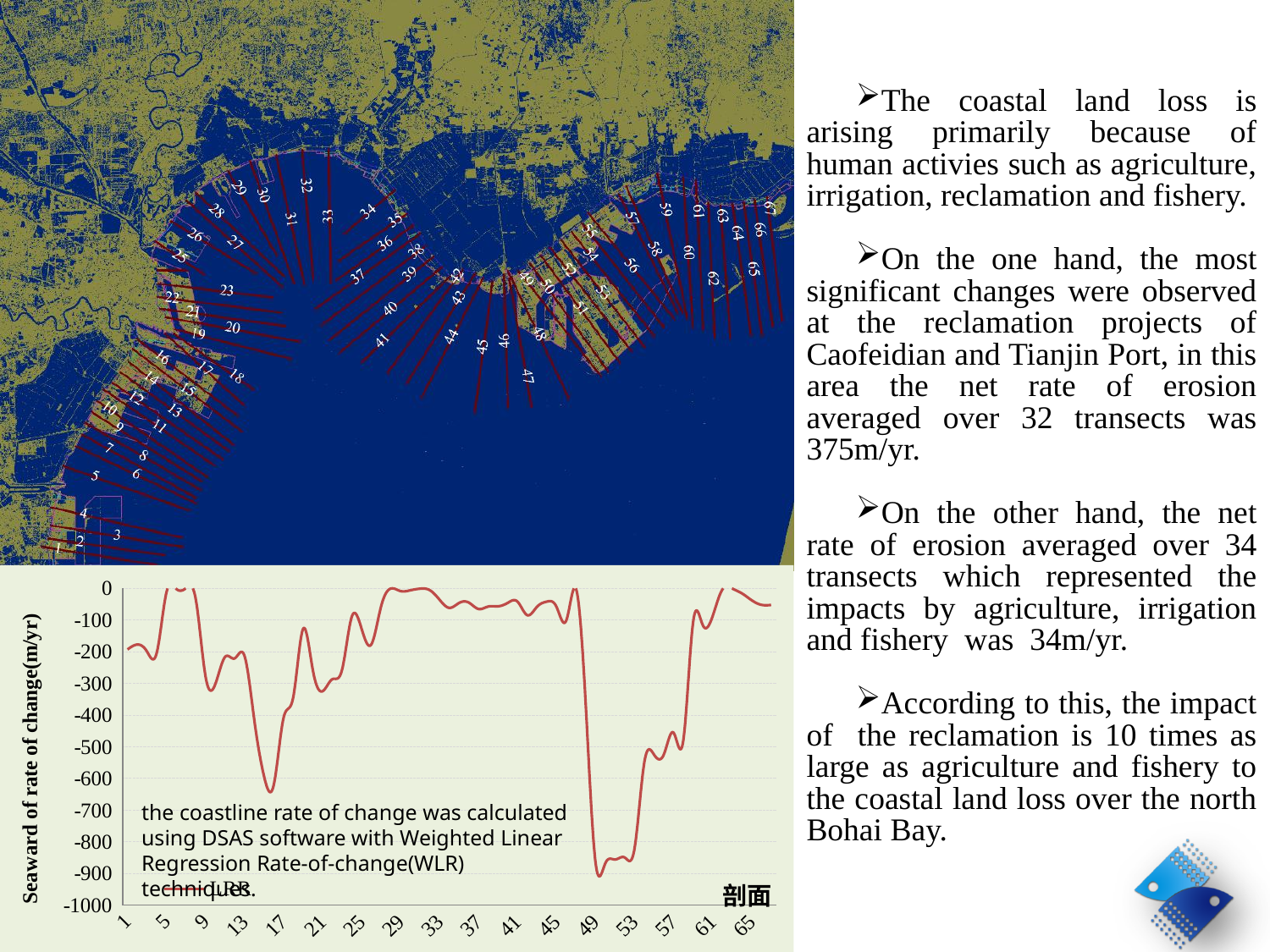
In the line chart, is the value at transect 51 greater or less than -800? less In the line chart, is the value at transect 17 greater or less than -500? greater What is the lowest value shown on the vertical axis of the line chart? -1000 What kind of chart is shown at the bottom left of the slide? line chart In the line chart, do the values rise or fall between transect 49 and transect 57? rise How many tick labels are printed along the horizontal axis of the line chart? 17 In the line chart, is the value at transect 5 greater or less than -100? greater In the line chart, which has the higher value: transect 1 or transect 29? transect 29 In the line chart, which has the lower value: transect 17 or transect 51? transect 51 What is the title of the vertical axis of the line chart? Seaward of rate of change(m/yr)